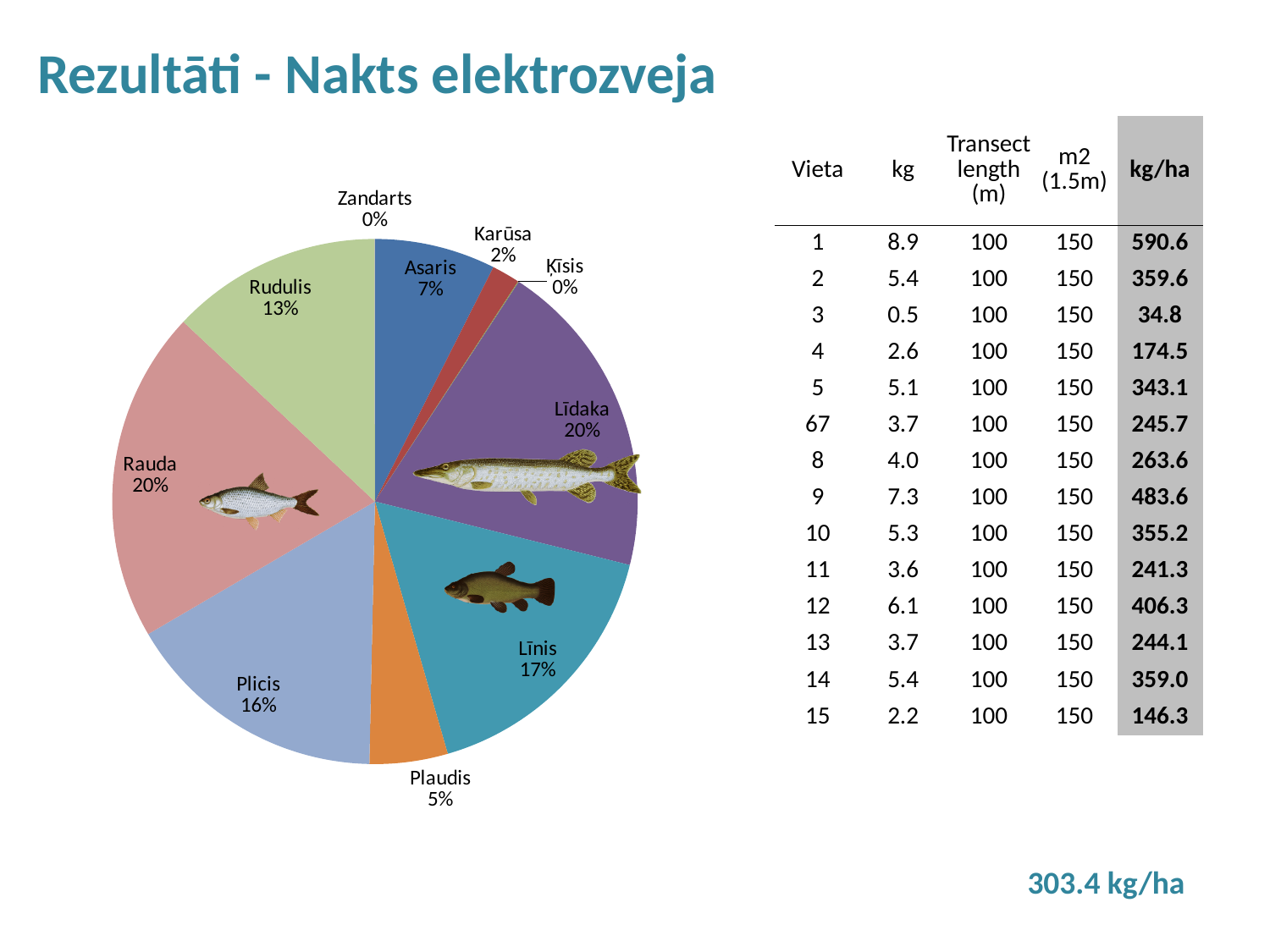
How many slices (categories) does the pie chart have? 10 What percentage is shown for Plaudis? 5% What type of chart is shown on the slide? pie chart What percentage is shown for Karūsa? 2% Which is larger, the share for Līnis or the share for Plicis? Līnis What share of the pie does Līdaka represent? 20% What percentage is shown for Asaris? 7% What percentage is shown for Līnis? 17% What share of the pie does Rudulis represent? 13% What is the difference in percentage points between Rauda and Rudulis? 7 What is the title of the slide containing the pie chart? Rezultāti - Nakts elektrozveja What percentage is shown for Plicis? 16%